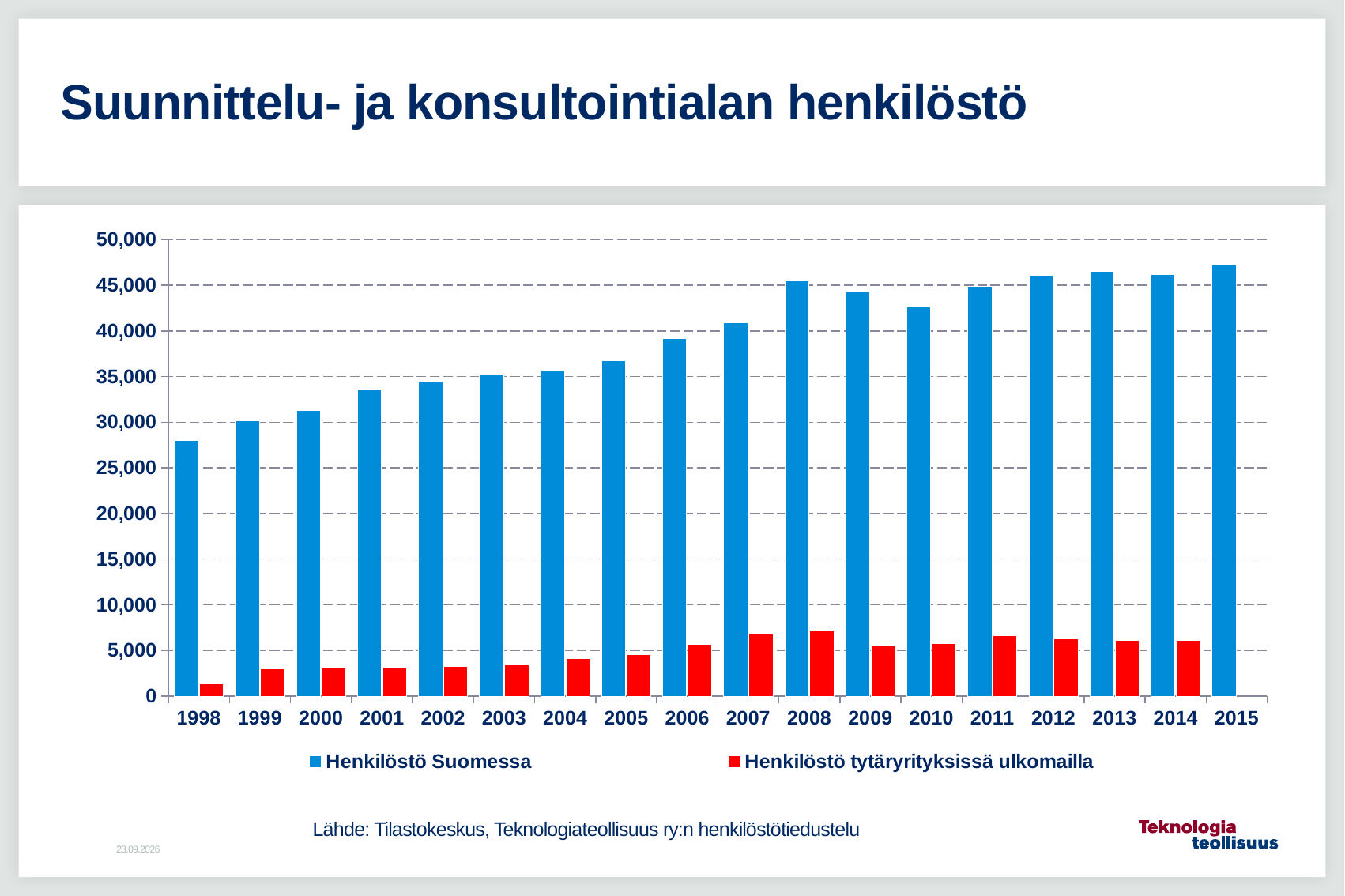
What is the title of the slide? Suunnittelu- ja konsultointialan henkilöstö Is the value for Henkilöstö Suomessa in 2015 greater or less than 45,000? greater Which year has the lowest value for Henkilöstö Suomessa? 1998 What kind of chart is shown on the slide? bar chart Which year has the lowest value for Henkilöstö tytäryrityksissä ulkomailla? 1998 How many years are shown on the x axis? 18 Which is larger, Henkilöstö Suomessa in 2008 or in 2010? 2008 Is the value for Henkilöstö Suomessa in 1998 greater or less than 30,000? less Is the value for Henkilöstö tytäryrityksissä ulkomailla in 2003 greater or less than 5,000? less How many series does the legend list? 2 Which year has the highest value for Henkilöstö Suomessa? 2015